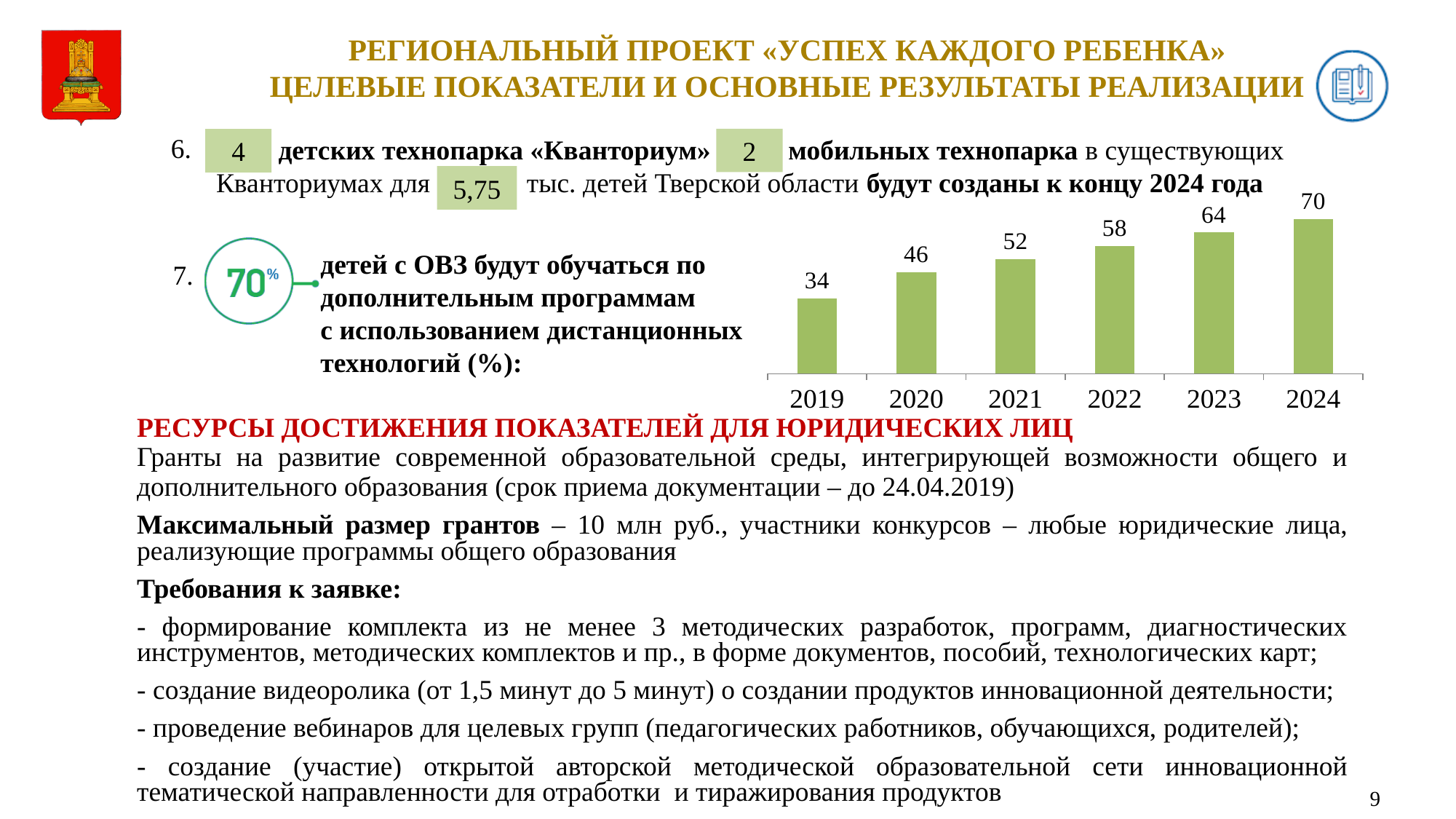
What colour are the bars in the chart? green What is the value shown for 2022 in the bar chart? 58 How many years are shown on the x axis of the bar chart? 6 What is the value shown for 2024 in the bar chart? 70 Which year has the highest value in the bar chart? 2024 Which is larger in the bar chart, the value for 2023 or the value for 2021? 2023 What is the value shown for 2019 in the bar chart? 34 Do the values in the bar chart rise or fall from 2019 to 2024? rise What is the difference between the values for 2024 and 2019 in the bar chart? 36 Which year has the lowest value in the bar chart? 2019 What kind of chart is shown on the slide? bar chart What is the difference between the values for 2021 and 2020 in the bar chart? 6